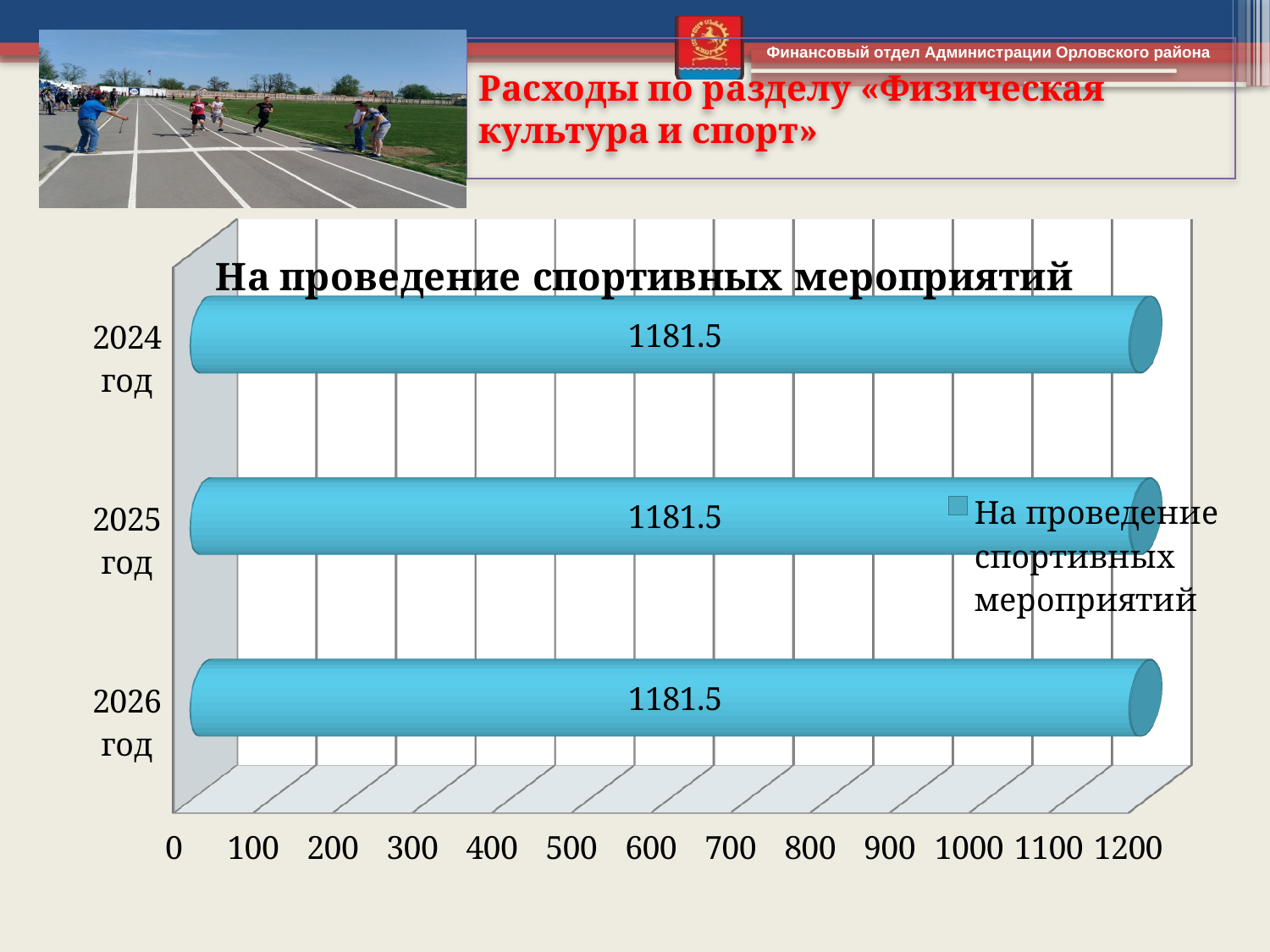
Do the values rise, fall or stay the same from 2024 год to 2026 год? stay the same What is the difference between the values for 2024 год and 2026 год? 0 What is the value for 2025 год in the chart? 1181.5 What is the legend entry of the chart? На проведение спортивных мероприятий What is the title of the chart? На проведение спортивных мероприятий How many series does the legend list? 1 What is the value for 2026 год in the chart? 1181.5 Is the value for 2025 год larger than, smaller than, or equal to the value for 2026 год? equal Is the value for 2024 год greater or less than 1000? greater How many categories (years) are shown in the chart? 3 What is the value for 2024 год in the chart? 1181.5 What kind of chart is shown on the slide? bar chart